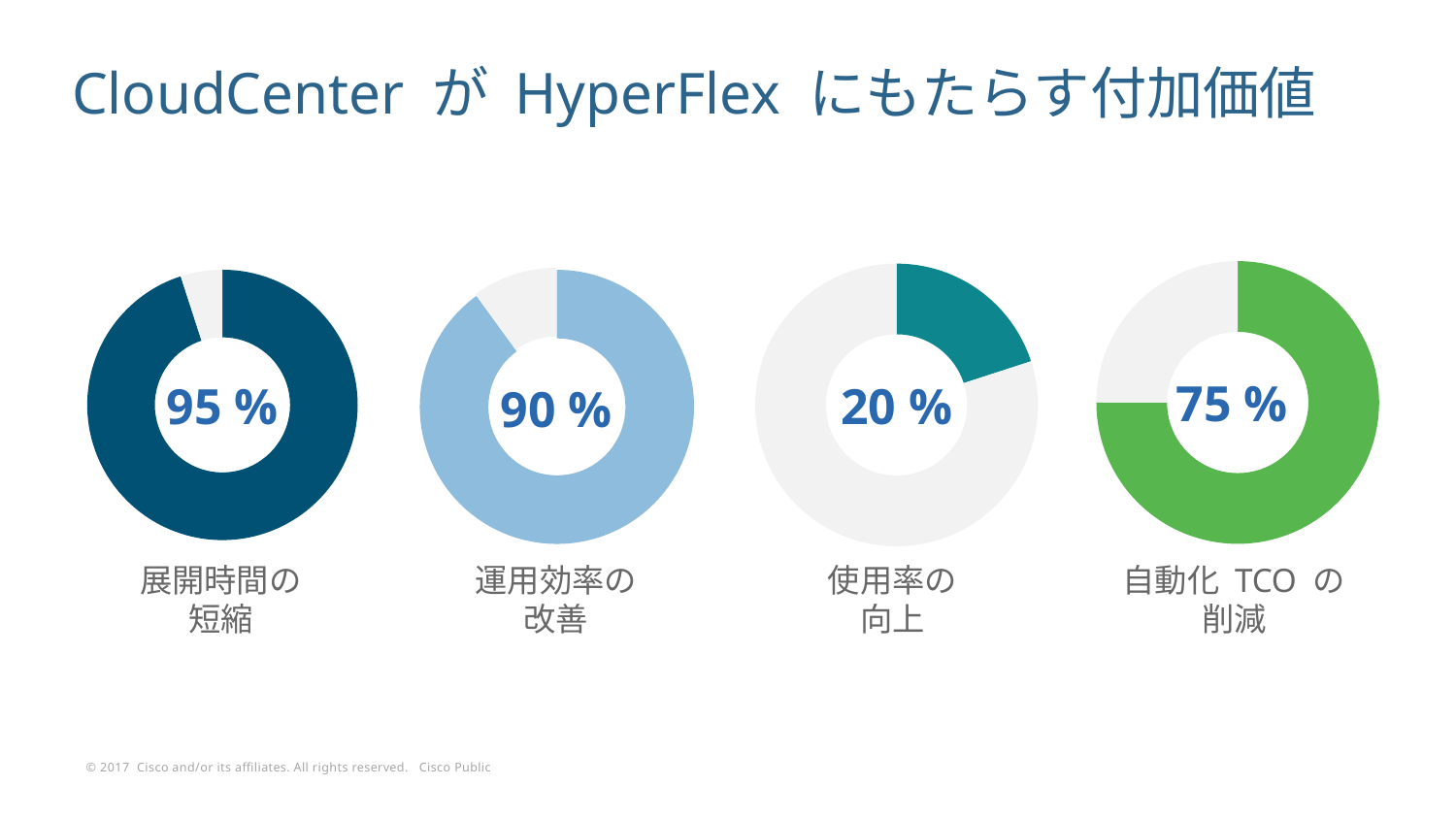
Which of the four donut charts shows the highest percentage? 展開時間の短縮 What is the title of the slide containing the four donut charts? CloudCenter が HyperFlex にもたらす付加価値 What value is shown in the donut chart labelled 展開時間の短縮? 95 % What value is shown in the donut chart labelled 運用効率の改善? 90 % Which of the four donut charts shows the lowest percentage? 使用率の向上 What value is shown in the donut chart labelled 自動化 TCO の削減? 75 % What is the difference between the percentage for 展開時間の短縮 and the percentage for 自動化 TCO の削減? 20 % How many donut charts are shown on the slide? 4 Which is larger, the percentage for 運用効率の改善 or the percentage for 使用率の向上? 運用効率の改善 What kind of chart is used to show the four percentages on the slide? Donut chart What colour is the filled portion of the donut chart labelled 自動化 TCO の削減? Green What value is shown in the donut chart labelled 使用率の向上? 20 %